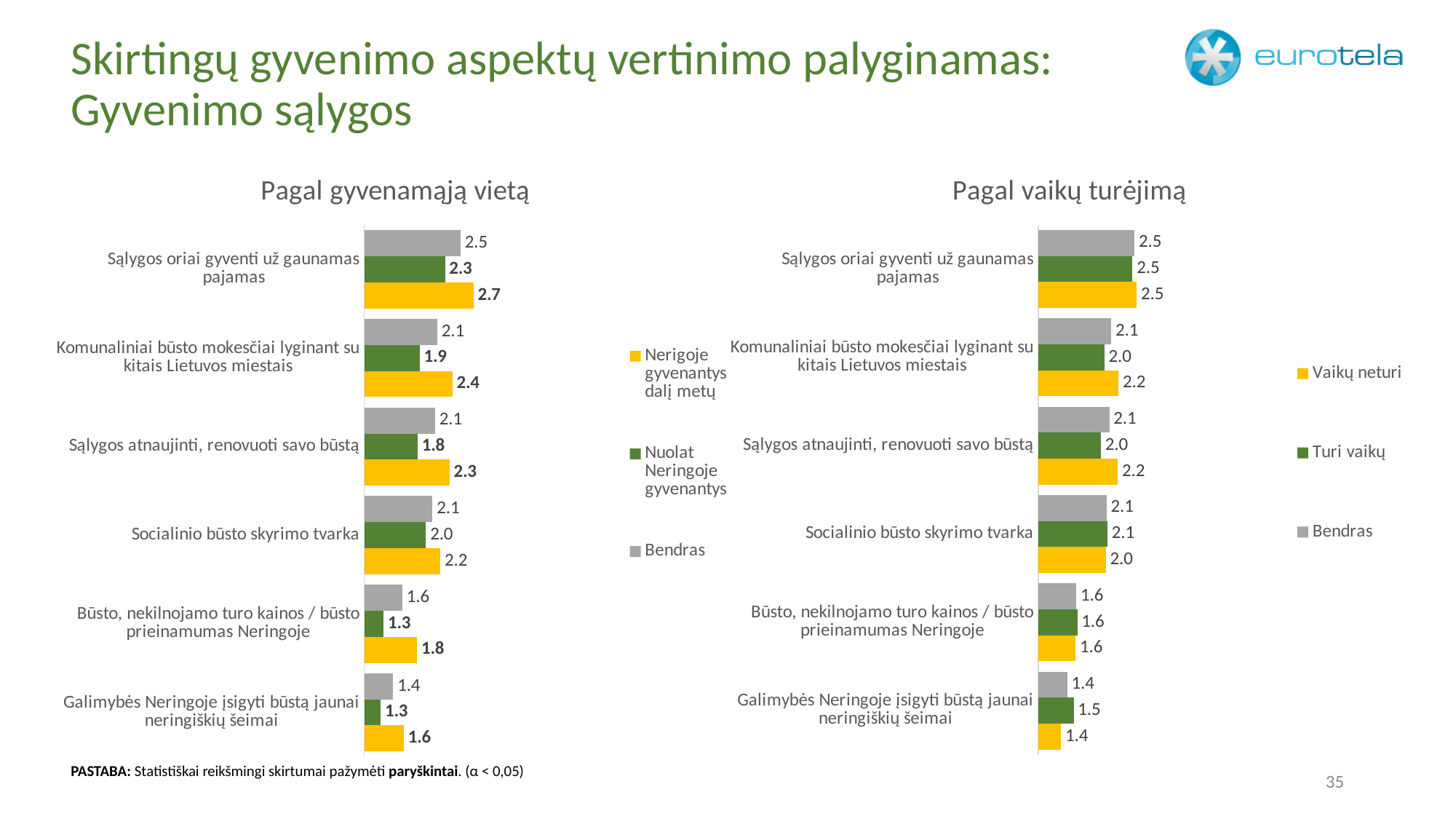
In the 'Pagal gyvenamąją vietą' chart, which category has the highest 'Bendras' value? Sąlygos oriai gyventi už gaunamas pajamas In the 'Pagal vaikų turėjimą' chart, which category has the lowest 'Vaikų neturi' value? Galimybės Neringoje įsigyti būstą jaunai neringiškių šeimai In the 'Pagal gyvenamąją vietą' chart, what is the difference between the 'Nerigoje gyvenantys dalį metų' and 'Nuolat Neringoje gyvenantys' values for 'Komunaliniai būsto mokesčiai lyginant su kitais Lietuvos miestais'? 0.5 In the 'Pagal vaikų turėjimą' chart, what is the 'Bendras' value for 'Komunaliniai būsto mokesčiai lyginant su kitais Lietuvos miestais'? 2.1 In the 'Pagal vaikų turėjimą' chart, for 'Socialinio būsto skyrimo tvarka', which is larger: 'Turi vaikų' or 'Vaikų neturi'? Turi vaikų In the 'Pagal vaikų turėjimą' chart, what is the 'Turi vaikų' value for 'Galimybės Neringoje įsigyti būstą jaunai neringiškių šeimai'? 1.5 How many series does the legend of the 'Pagal vaikų turėjimą' chart list? 3 How many categories are shown in the 'Pagal gyvenamąją vietą' chart? 6 In the 'Pagal gyvenamąją vietą' chart, what is the value for 'Nerigoje gyvenantys dalį metų' for 'Sąlygos oriai gyventi už gaunamas pajamas'? 2.7 In the 'Pagal gyvenamąją vietą' chart, what is the 'Nuolat Neringoje gyvenantys' value for 'Būsto, nekilnojamo turo kainos / būsto prieinamumas Neringoje'? 1.3 In the 'Pagal vaikų turėjimą' chart, which colour represents 'Vaikų neturi'? Yellow What type of chart is 'Pagal gyvenamąją vietą'? Bar chart